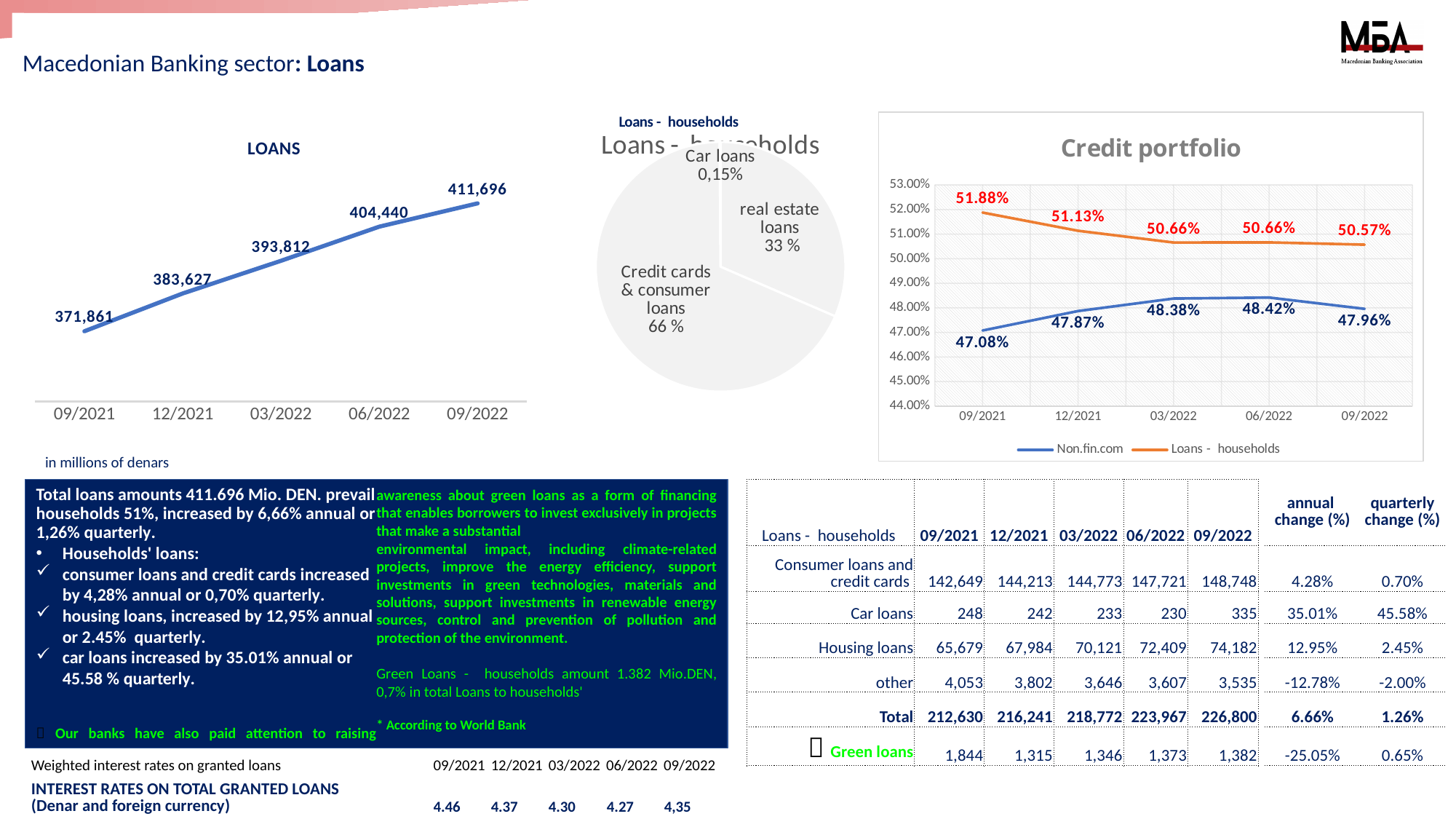
How many series does the legend of the Credit portfolio chart list? 2 In the Loans - households pie chart, what share do Credit cards & consumer loans have? 66 % How many data points are plotted in the LOANS chart? 5 In the Credit portfolio chart, what is the value for Loans - households at 09/2021? 51.88% In the LOANS chart, what is the difference between the 09/2022 value and the 09/2021 value? 39,835 In the Loans - households pie chart, which slice is the largest? Credit cards & consumer loans In the Loans - households pie chart, which slice is the smallest? Car loans In the LOANS chart, what is the value for 09/2022? 411,696 In the LOANS chart, do the values rise or fall from 09/2021 to 09/2022? rise In the Credit portfolio chart, what is the value for Non.fin.com at 06/2022? 48.42% What kind of chart is the LOANS chart? line chart In the LOANS chart, what is the value for 09/2021? 371,861